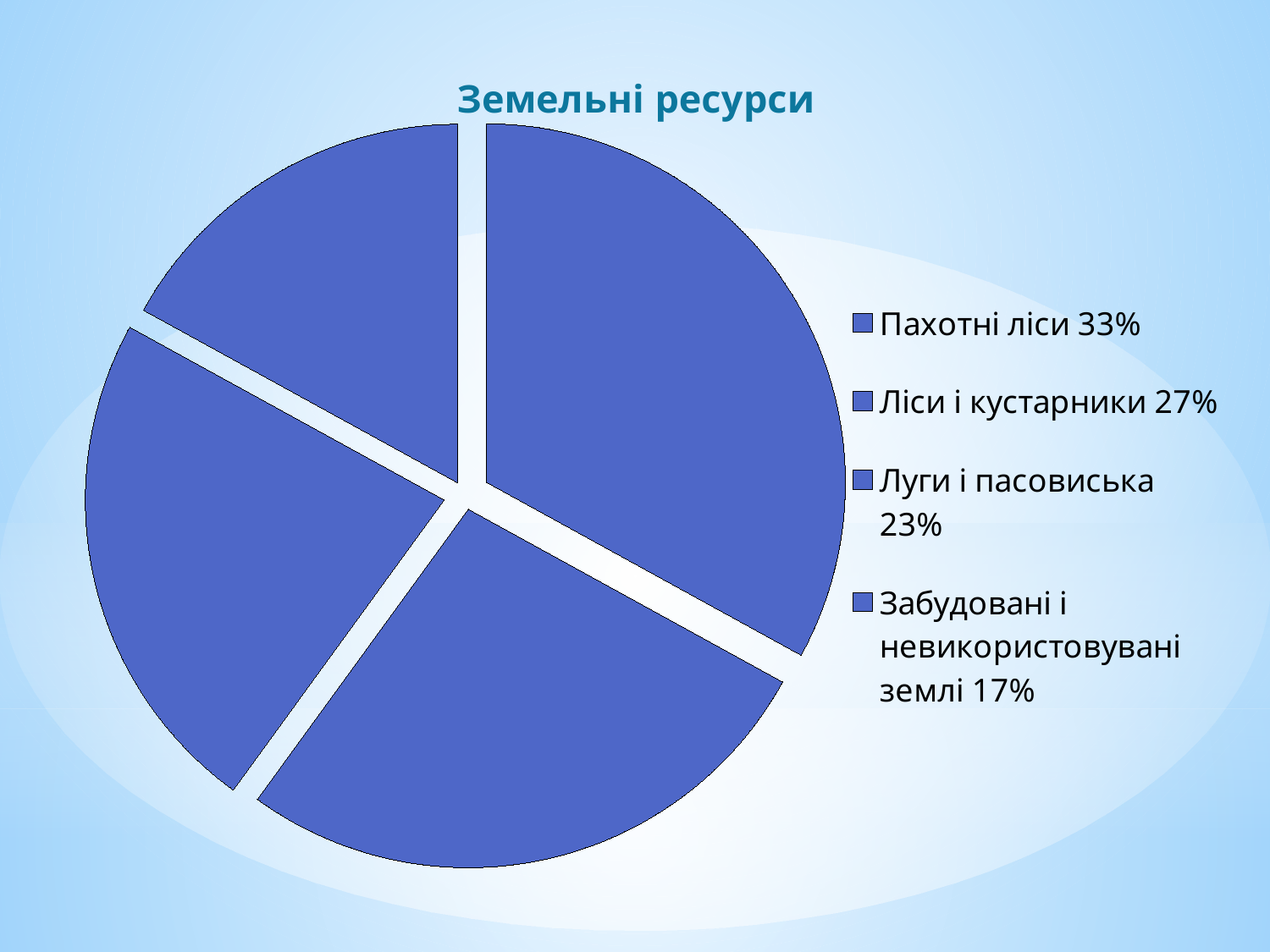
Are the slices of the pie chart shown in different colours or the same colour? the same colour How many slices does the pie chart have? 4 Which category has the smallest share of the pie? Забудовані і невикористовувані землі What share of the pie is Пахотні ліси? 33% What is the difference in percentage points between Пахотні ліси and Ліси і кустарники? 6 What kind of chart is shown on the slide? pie chart What percentage is shown for Луги і пасовиська? 23% Which is larger, the share for Луги і пасовиська or the share for Забудовані і невикористовувані землі? Луги і пасовиська What percentage is shown for Ліси і кустарники? 27% Which category has the largest share of the pie? Пахотні ліси What is the title of the chart? Земельні ресурси What percentage is shown for Забудовані і невикористовувані землі? 17%